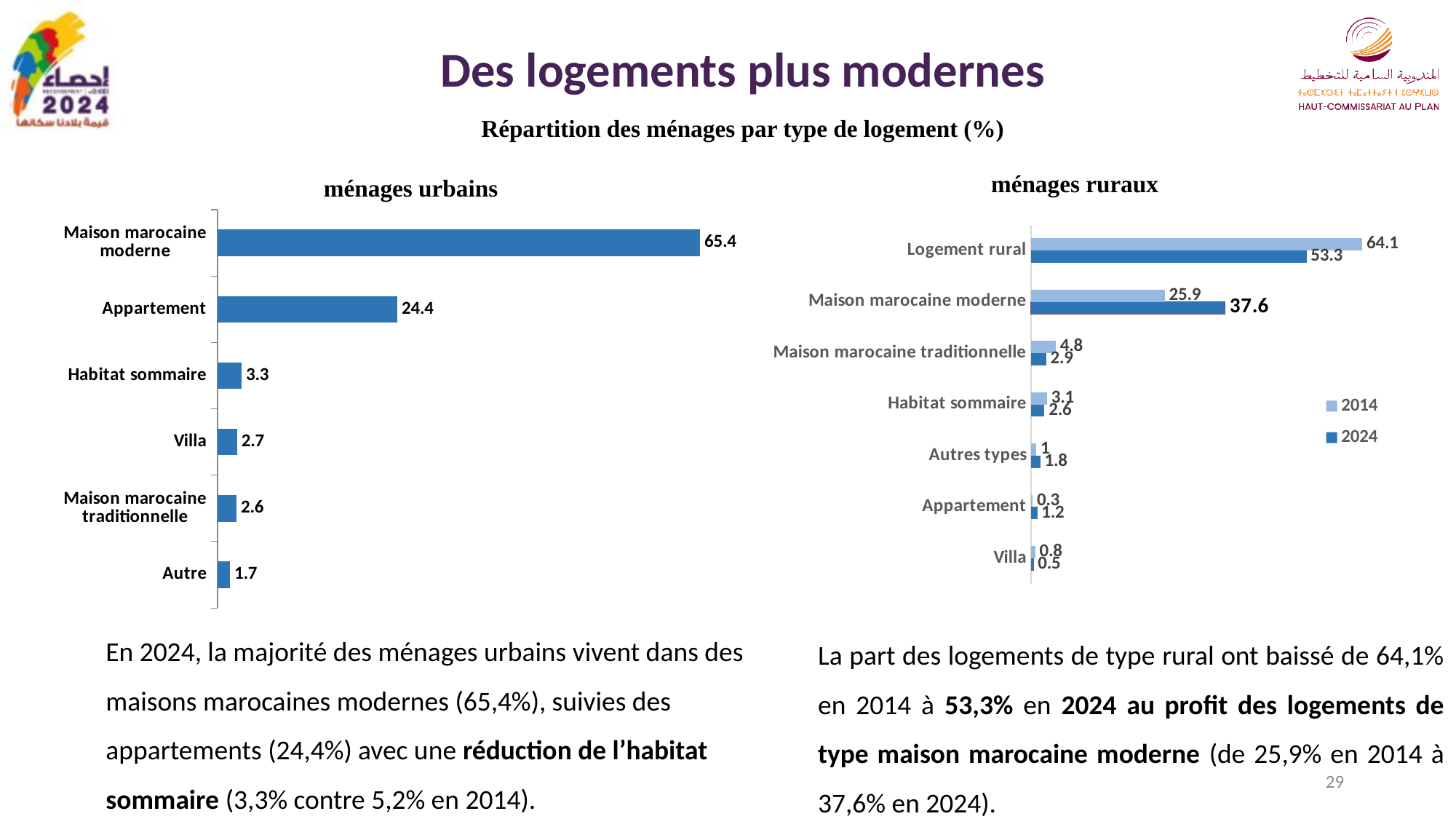
In the 'ménages urbains' chart, what is the difference between Maison marocaine moderne and Appartement? 41.0 In the 'ménages ruraux' chart, what is the difference between the 2014 and 2024 values for Logement rural? 10.8 In the 'ménages ruraux' chart, which is larger for Habitat sommaire: the 2014 value or the 2024 value? 2014 In the 'ménages ruraux' chart, how many series does the legend list? 2 In the 'ménages urbains' chart, what is the value for Appartement? 24.4 In the 'ménages ruraux' chart, how many categories are shown? 7 In the 'ménages ruraux' chart, what is the 2024 value for Logement rural? 53.3 In the 'ménages urbains' chart, which category has the highest value? Maison marocaine moderne In the 'ménages ruraux' chart, what is the 2014 value for Maison marocaine moderne? 25.9 What kind of chart is the 'ménages ruraux' chart? Bar chart In the 'ménages urbains' chart, which category has the lowest value? Autre In the 'ménages urbains' chart, how many categories are shown? 6